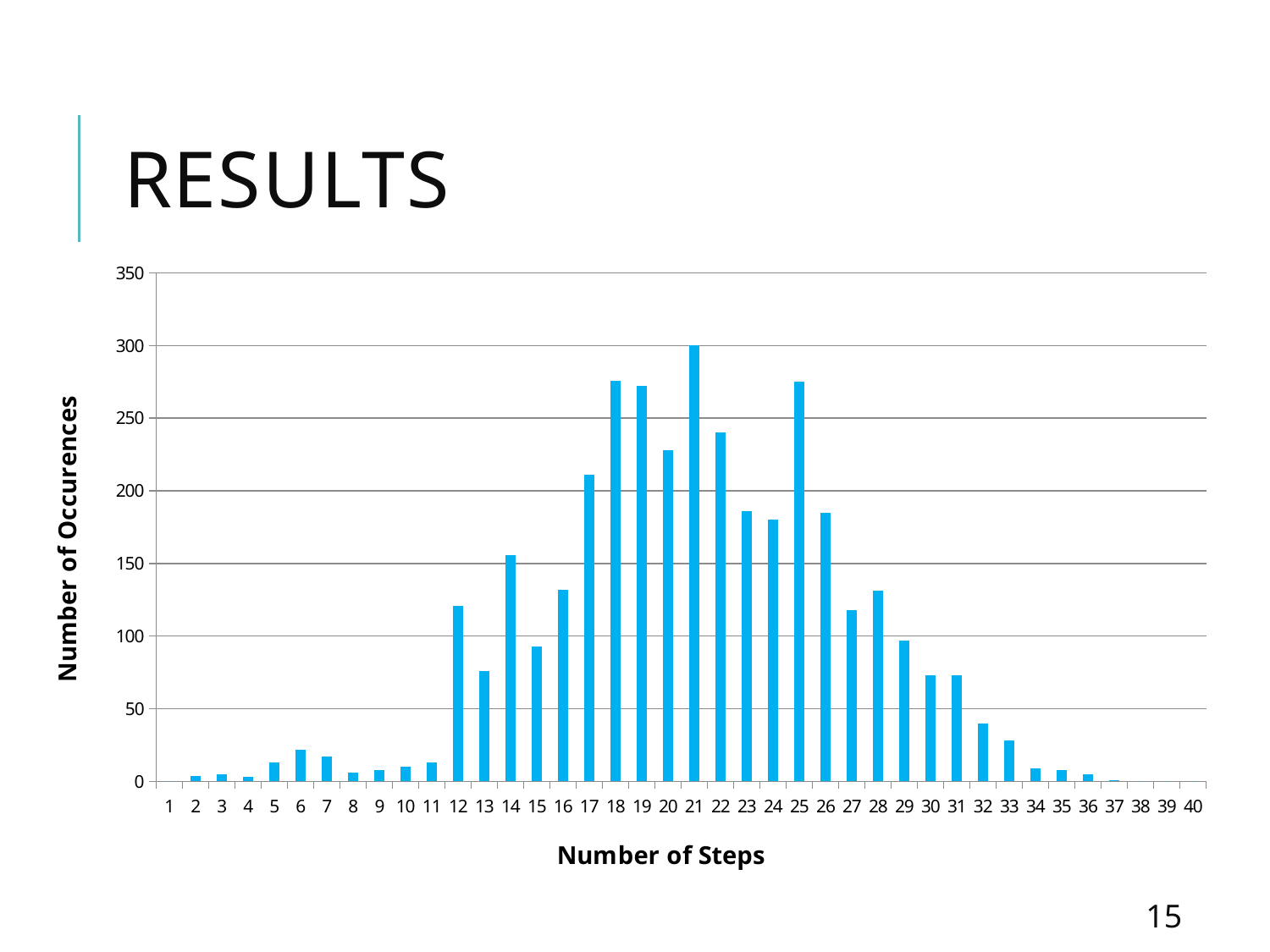
What is the title of the y axis? Number of Occurences Is the number of occurrences for 12 steps greater or less than 100? greater Which number of steps has the highest number of occurrences? 21 Is the number of occurrences for 32 steps greater or less than 50? less Is the number of occurrences for 22 steps greater or less than 250? less What kind of chart is shown on the slide? bar chart From 30 steps to 36 steps, do the number of occurrences rise or fall? fall Which has more occurrences, 16 steps or 15 steps? 16 steps Which has more occurrences, 18 steps or 13 steps? 18 steps What is the number of occurrences for 21 steps? 300 How many categories are shown on the x axis? 40